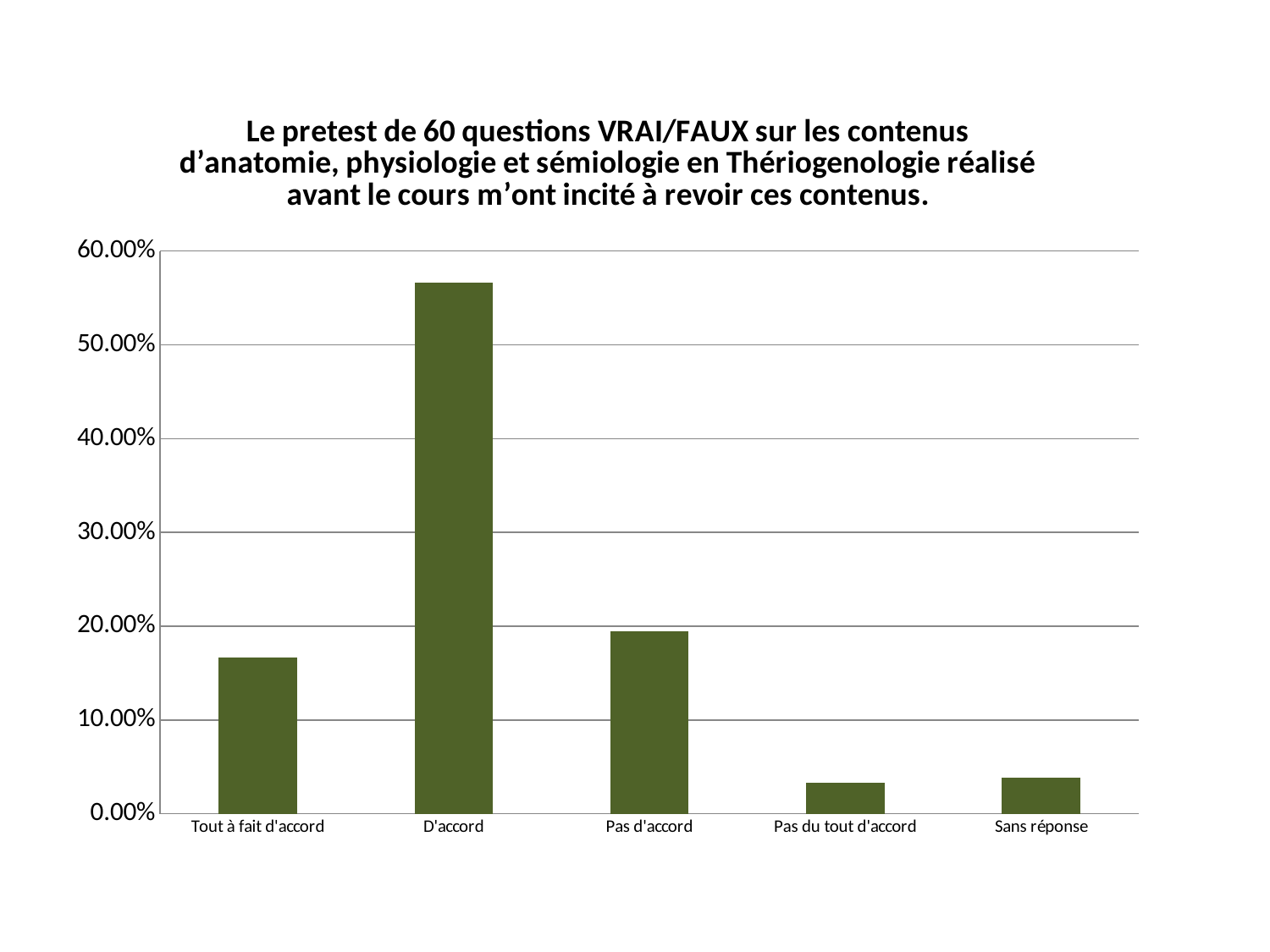
Which category has the highest value? D'accord Is the value for Tout à fait d'accord greater or less than 10.00%? greater Is the value for Tout à fait d'accord greater or less than 20.00%? less Is the value for Sans réponse greater or less than 10.00%? less What kind of chart is shown on the slide? bar chart Which is larger, the value for Pas d'accord or the value for Tout à fait d'accord? Pas d'accord What is the highest value shown on the vertical axis? 60.00% Which is larger, the value for D'accord or the value for Pas d'accord? D'accord How many categories are shown on the x axis? 5